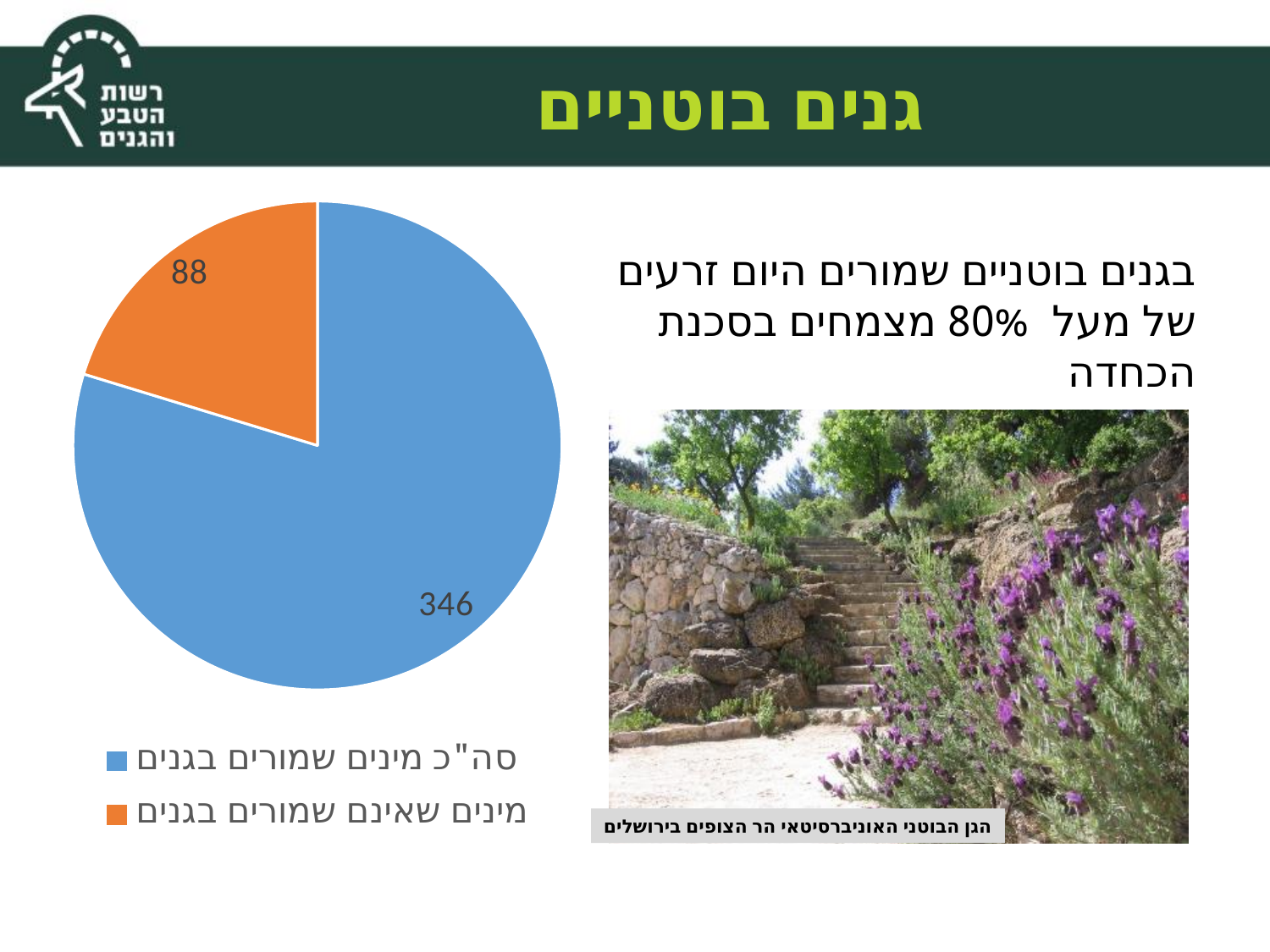
What colour is the slice for מינים שאינם שמורים בגנים? orange What colour is the slice for סה"כ מינים שמורים בגנים? blue How many slices does the pie chart have? 2 Which category has the smallest slice in the pie chart? מינים שאינם שמורים בגנים Which is larger: the value for סה"כ מינים שמורים בגנים or the value for מינים שאינם שמורים בגנים? סה"כ מינים שמורים בגנים What is the difference between the two slice values in the pie chart? 258 What is the value of the blue slice labelled סה"כ מינים שמורים בגנים? 346 What type of chart is shown on the slide? pie chart What is the value of the orange slice labelled מינים שאינם שמורים בגנים? 88 What is the sum of the two values shown in the pie chart? 434 How many entries does the legend list? 2 Which category has the largest slice in the pie chart? סה"כ מינים שמורים בגנים